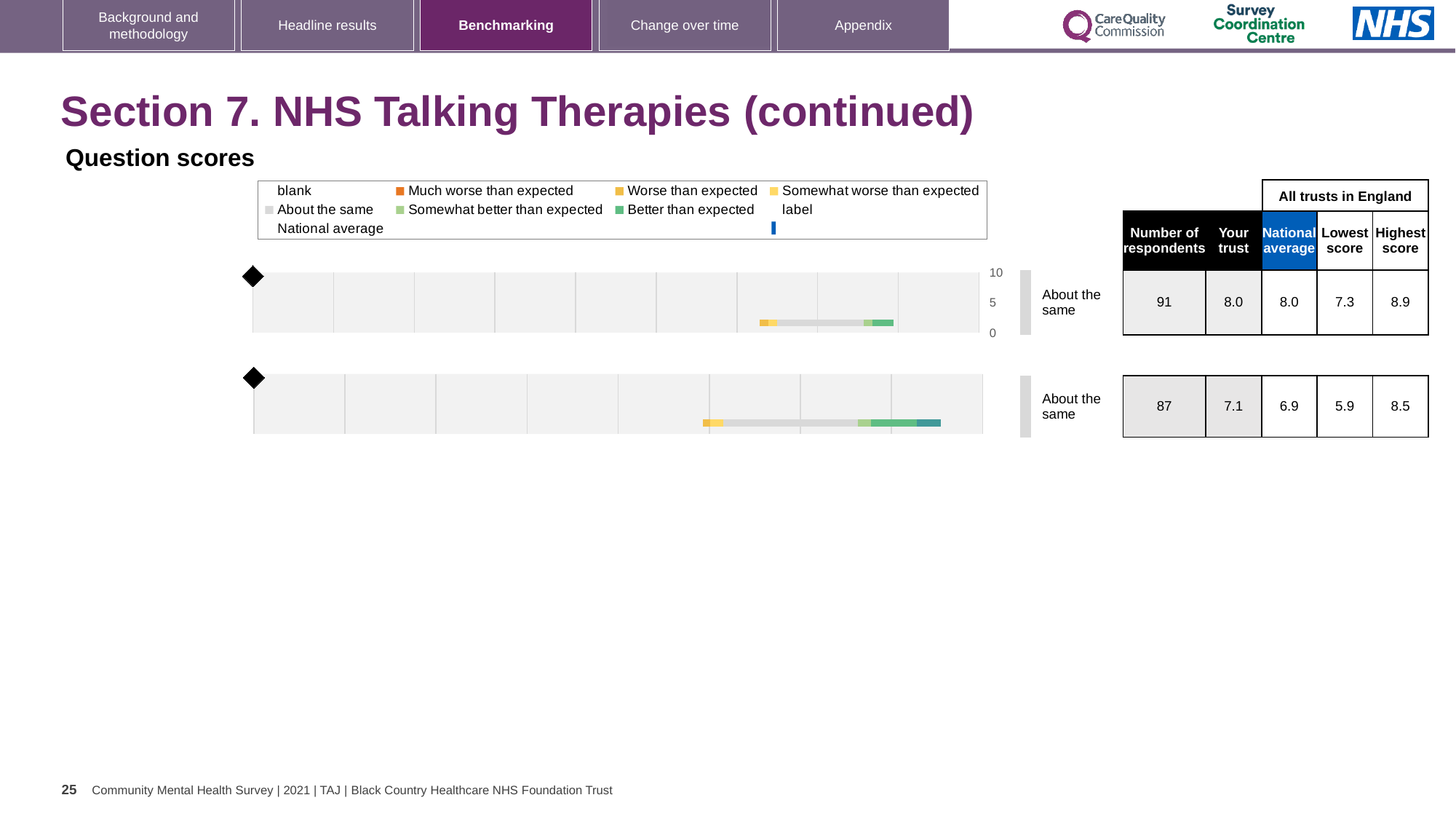
How many question score charts are shown on the slide? 2 For the first (top) chart, what is the 'Your trust' score shown in the table? 8.0 For the first (top) chart, how many respondents are listed? 91 For the second (bottom) chart, what is the lowest score among all trusts in England? 5.9 For the second (bottom) chart, what is the difference between the highest score and the lowest score? 2.6 Is the 'Your trust' score for the first (top) chart greater or less than 5? greater What kind of chart is used to show the question scores on this slide? bar chart For the first (top) chart, what is the highest score among all trusts in England? 8.9 What benchmark category is given for the second (bottom) chart? About the same For the second (bottom) chart, what is the national average score? 6.9 For the first (top) chart, what is the difference between the highest score and the lowest score? 1.6 For the second (bottom) chart, which is larger: the 'Your trust' score or the national average? Your trust